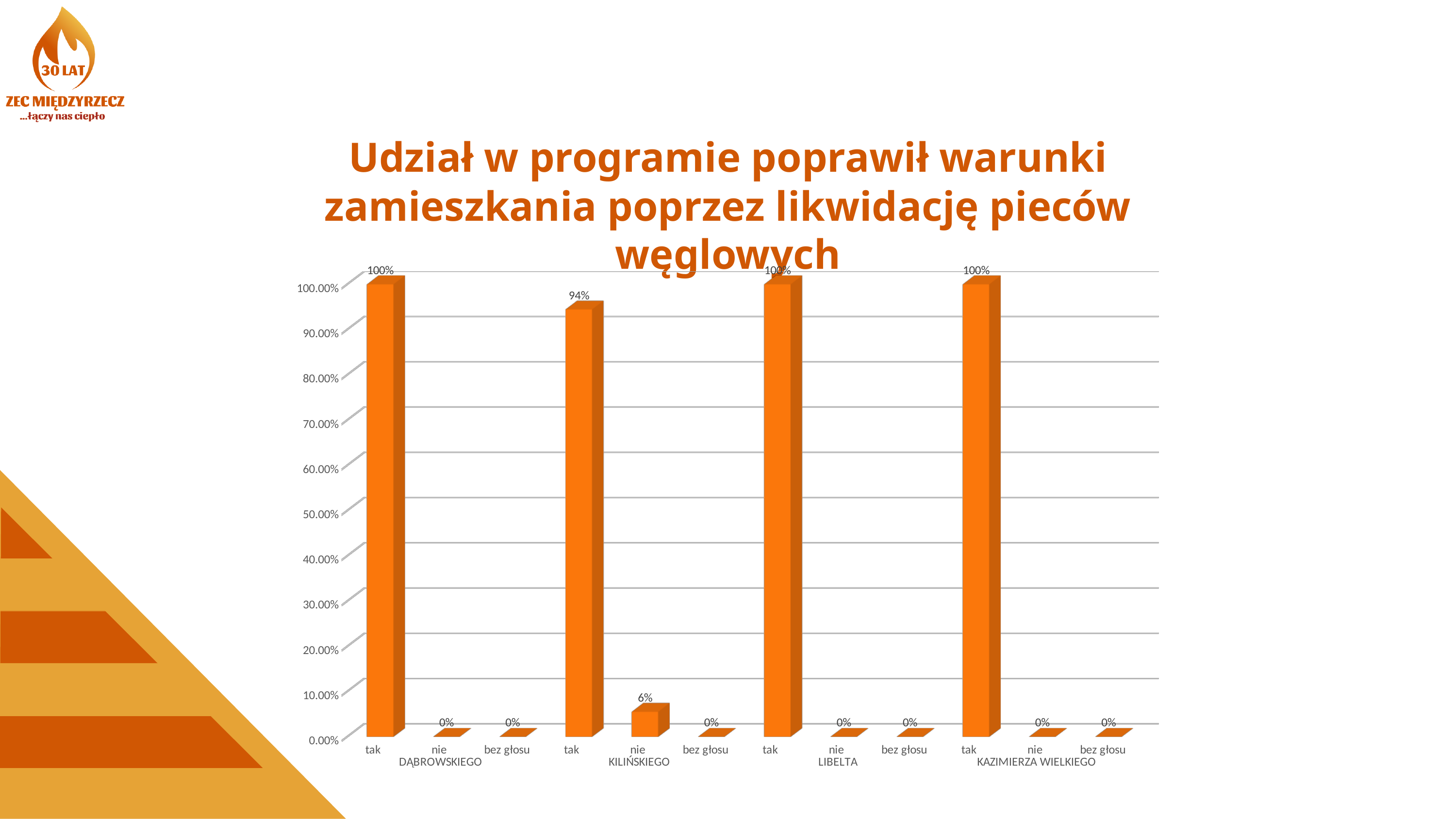
Is the value for "tak" in the KILIŃSKIEGO group greater or less than 90.00%? greater What is the value for "tak" in the DĄBROWSKIEGO group? 100% What is the difference between the "tak" and "nie" values in the KILIŃSKIEGO group? 88% What is the value for "nie" in the KAZIMIERZA WIELKIEGO group? 0% What kind of chart is shown on the slide? bar chart How many street groups are shown on the x axis? 4 Which is larger: the "tak" value for LIBELTA or the "tak" value for KILIŃSKIEGO? LIBELTA What is the value for "bez głosu" in the LIBELTA group? 0% What is the value for "tak" in the KILIŃSKIEGO group? 94% What is the title of the chart? Udział w programie poprawił warunki zamieszkania poprzez likwidację pieców węglowych Which street group has the lowest "tak" value? KILIŃSKIEGO What is the value for "nie" in the KILIŃSKIEGO group? 6%